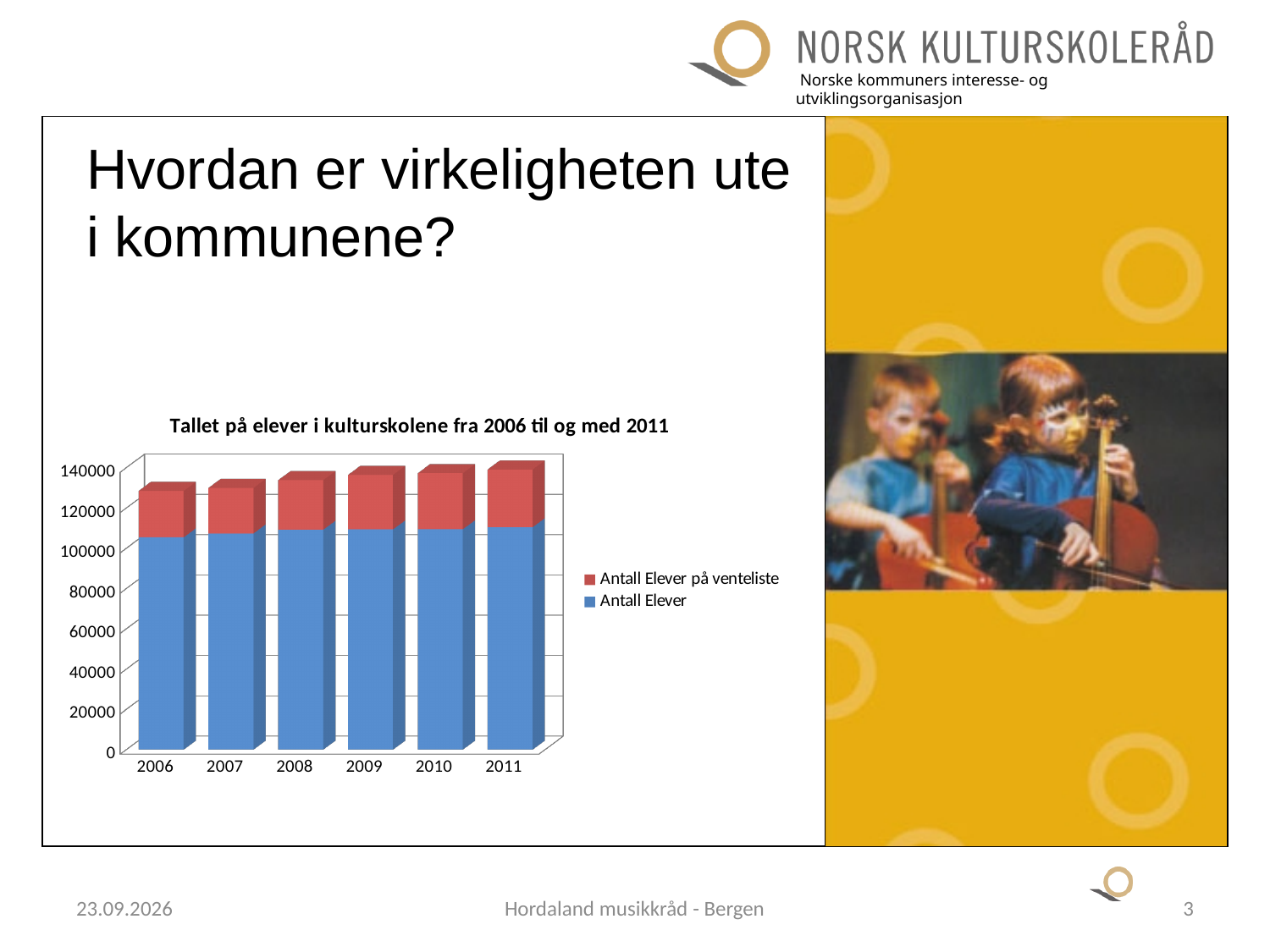
Is the total of the stacked bar for 2011 greater or less than 120000? greater Is the value for Antall Elever in 2006 greater or less than 80000? greater Is the value for Antall Elever på venteliste in 2011 greater or less than 60000? less What kind of chart is shown on the slide? stacked bar chart Which series is shown in red in the chart? Antall Elever på venteliste How many series does the chart's legend list? 2 What is the highest value shown on the vertical axis of the chart? 140000 Which series has the larger value in 2009, Antall Elever or Antall Elever på venteliste? Antall Elever What is the title of the chart? Tallet på elever i kulturskolene fra 2006 til og med 2011 Do the total heights of the stacked bars rise or fall from 2006 to 2011? rise How many years are shown on the x axis of the chart? 6